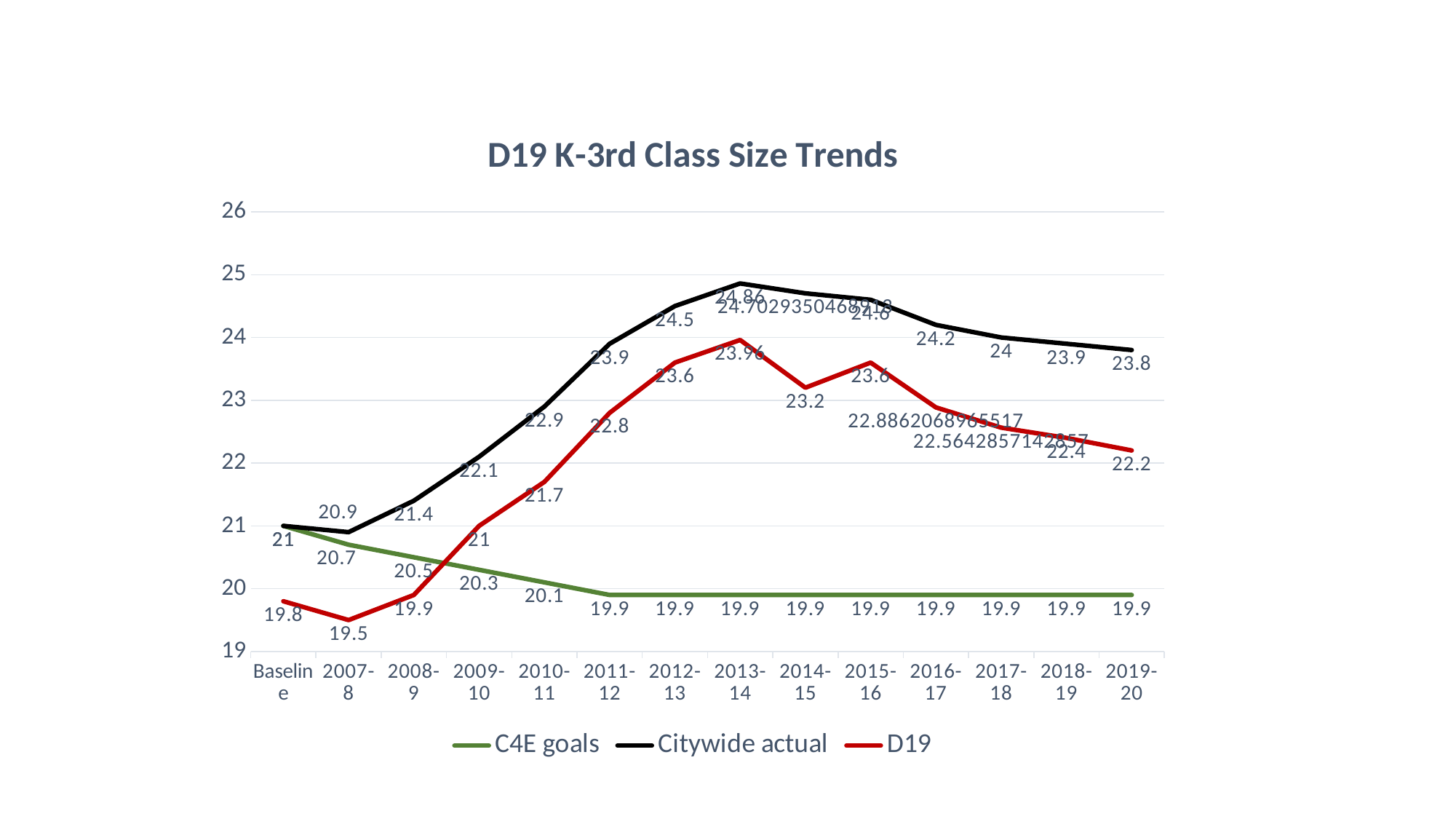
What kind of chart is shown on the slide? line chart What is the C4E goals value for 2010-11? 20.1 What is the D19 value for 2007-8? 19.5 What is the difference between the Citywide actual and D19 values for 2019-20? 1.6 How many categories are shown along the x axis? 14 What is the Citywide actual value for 2013-14? 24.86 In which year is the D19 value lowest? 2007-8 In which year is the Citywide actual value highest? 2013-14 Which is larger in 2012-13, the Citywide actual value or the D19 value? Citywide actual What is the D19 value for 2019-20? 22.2 How many series does the legend list? 3 Do the C4E goals values rise or fall from Baseline to 2011-12? fall